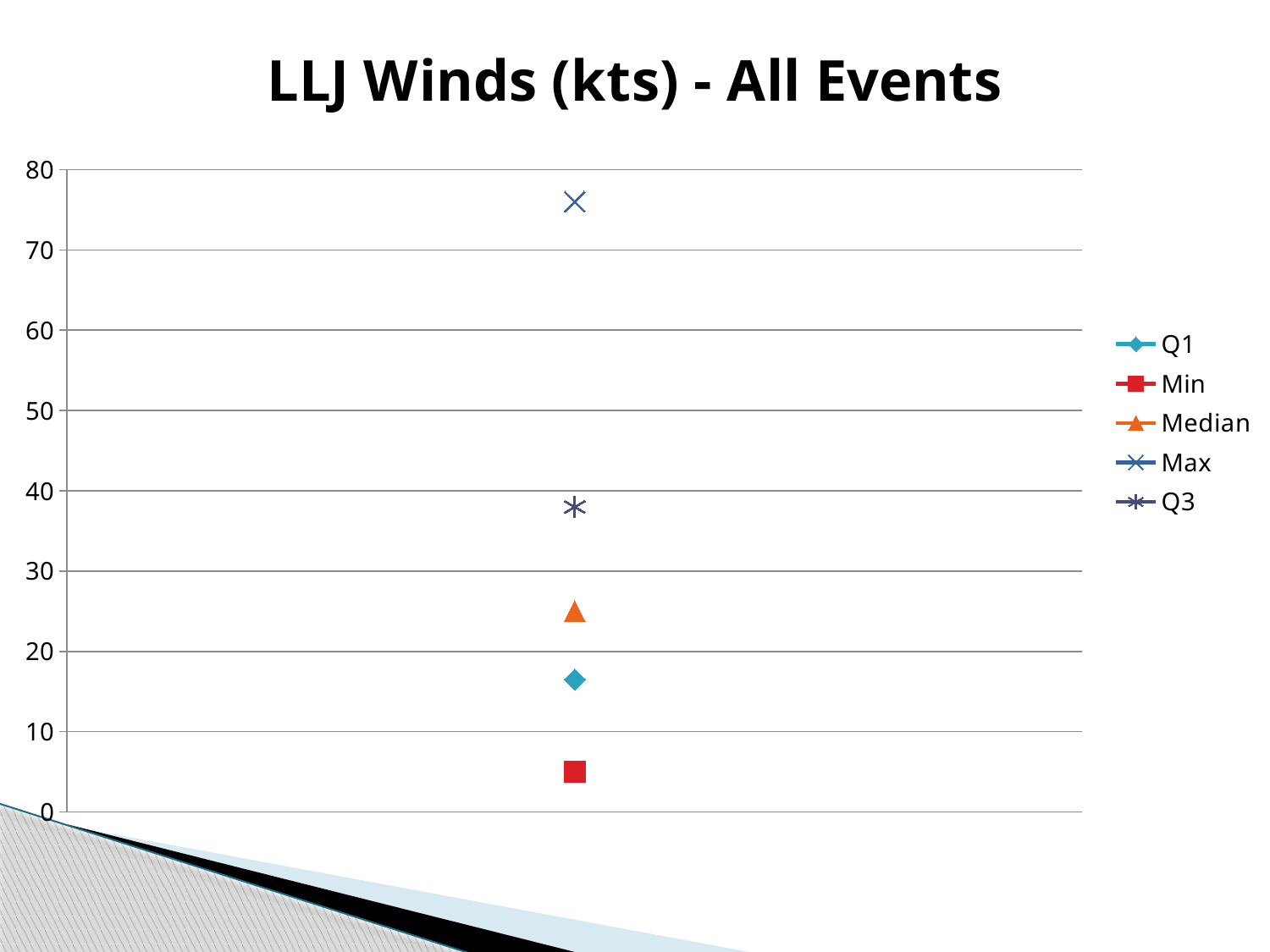
What is the title of the chart? LLJ Winds (kts) - All Events Is the value for Q1 greater or less than 20? less Is the value for Max greater or less than 70? greater What marker shape is used for the Median series? Triangle How many series does the legend list? 5 Is the value for Q3 greater or less than 40? less Which is larger, the value for Q1 or the value for Min? Q1 Which series has the highest plotted value? Max Which is larger, the value for Q3 or the value for Median? Q3 Which series has the lowest plotted value? Min